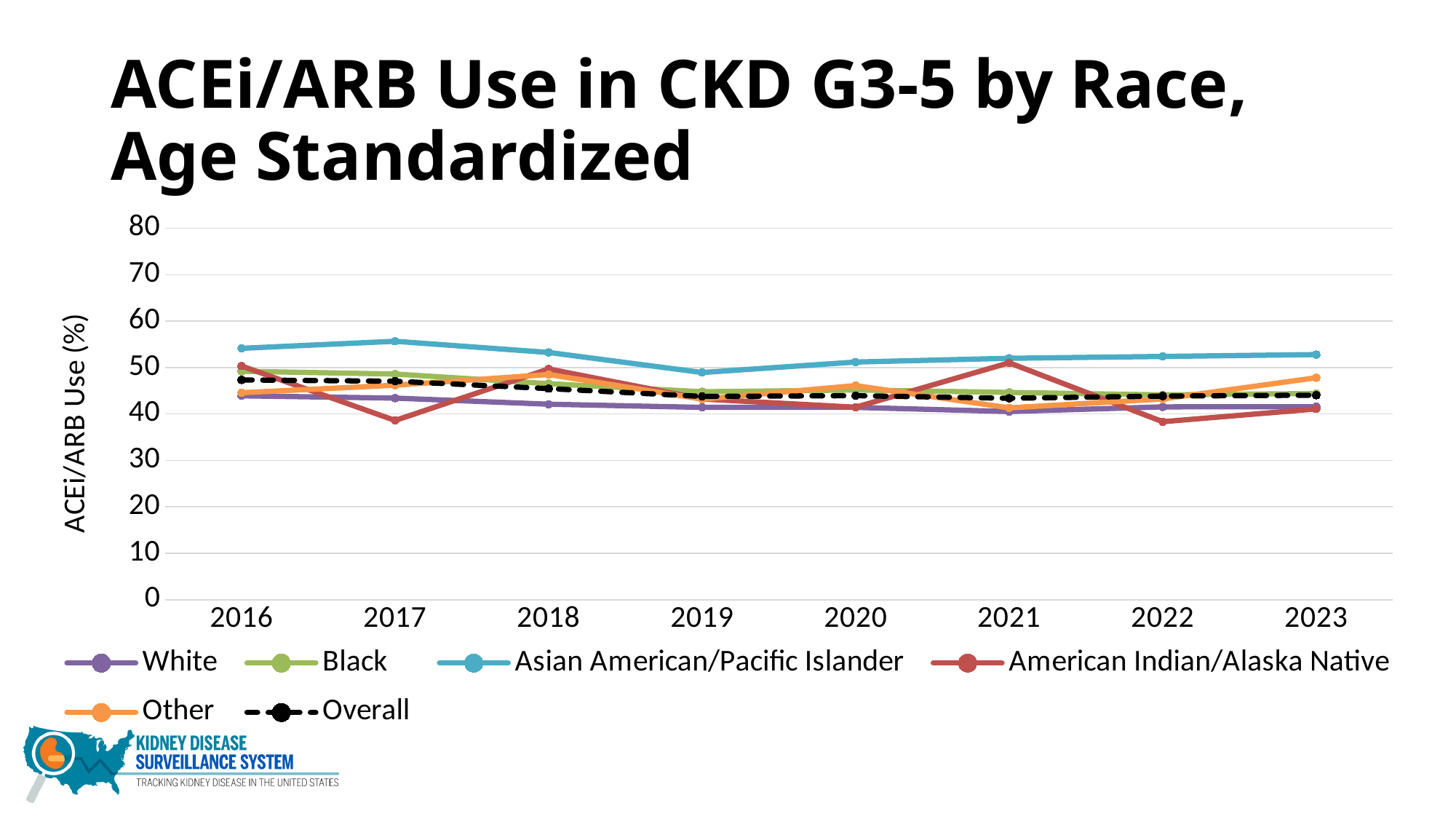
How many series does the legend list? 6 Does the White line rise or fall from 2016 to 2021? fall Which race group has the lowest ACEi/ARB use in 2017? American Indian/Alaska Native Is the value for White in 2023 greater or less than 50? less Is the value for Asian American/Pacific Islander in 2017 greater or less than 50? greater Which series is drawn with a dashed line? Overall Which race group has the lowest ACEi/ARB use in 2022? American Indian/Alaska Native How many years are plotted along the x axis? 8 Which race group has the highest ACEi/ARB use in 2017? Asian American/Pacific Islander In 2019, which is larger: the value for Asian American/Pacific Islander or the value for White? Asian American/Pacific Islander What kind of chart is shown on the slide? line chart Is the value for American Indian/Alaska Native in 2017 greater or less than 40? less